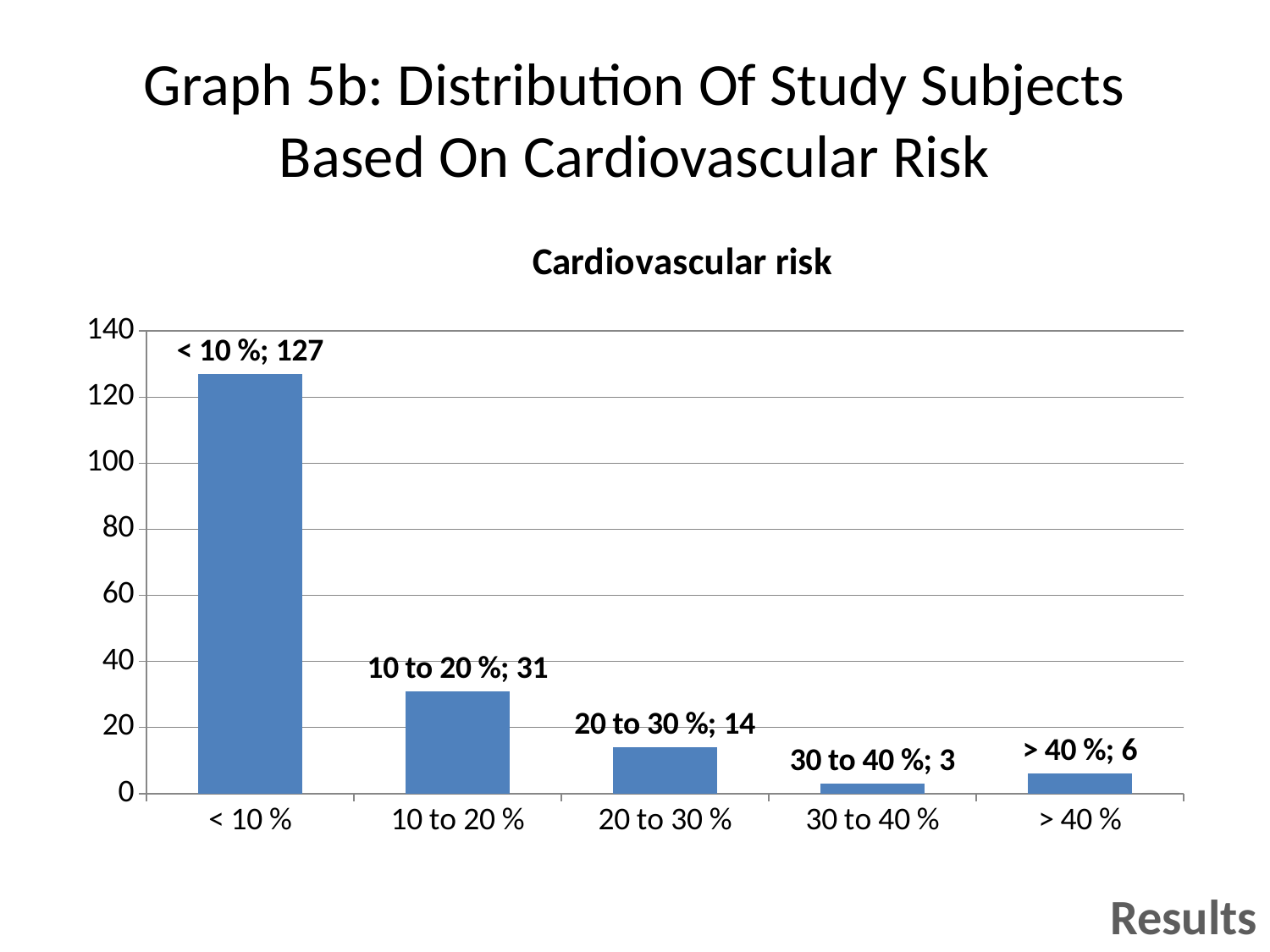
What is the value for the 20 to 30 % category? 14 Which is larger, the value for 20 to 30 % or the value for > 40 %? 20 to 30 % Which category has the lowest value? 30 to 40 % What is the value for the < 10 % category? 127 What is the difference between the values for < 10 % and 10 to 20 %? 96 What kind of chart is shown on the slide? Bar chart What is the value for the > 40 % category? 6 Which category has the highest value? < 10 % How many categories are shown on the x axis? 5 What is the value for the 10 to 20 % category? 31 What is the title of the chart? Cardiovascular risk What is the value for the 30 to 40 % category? 3